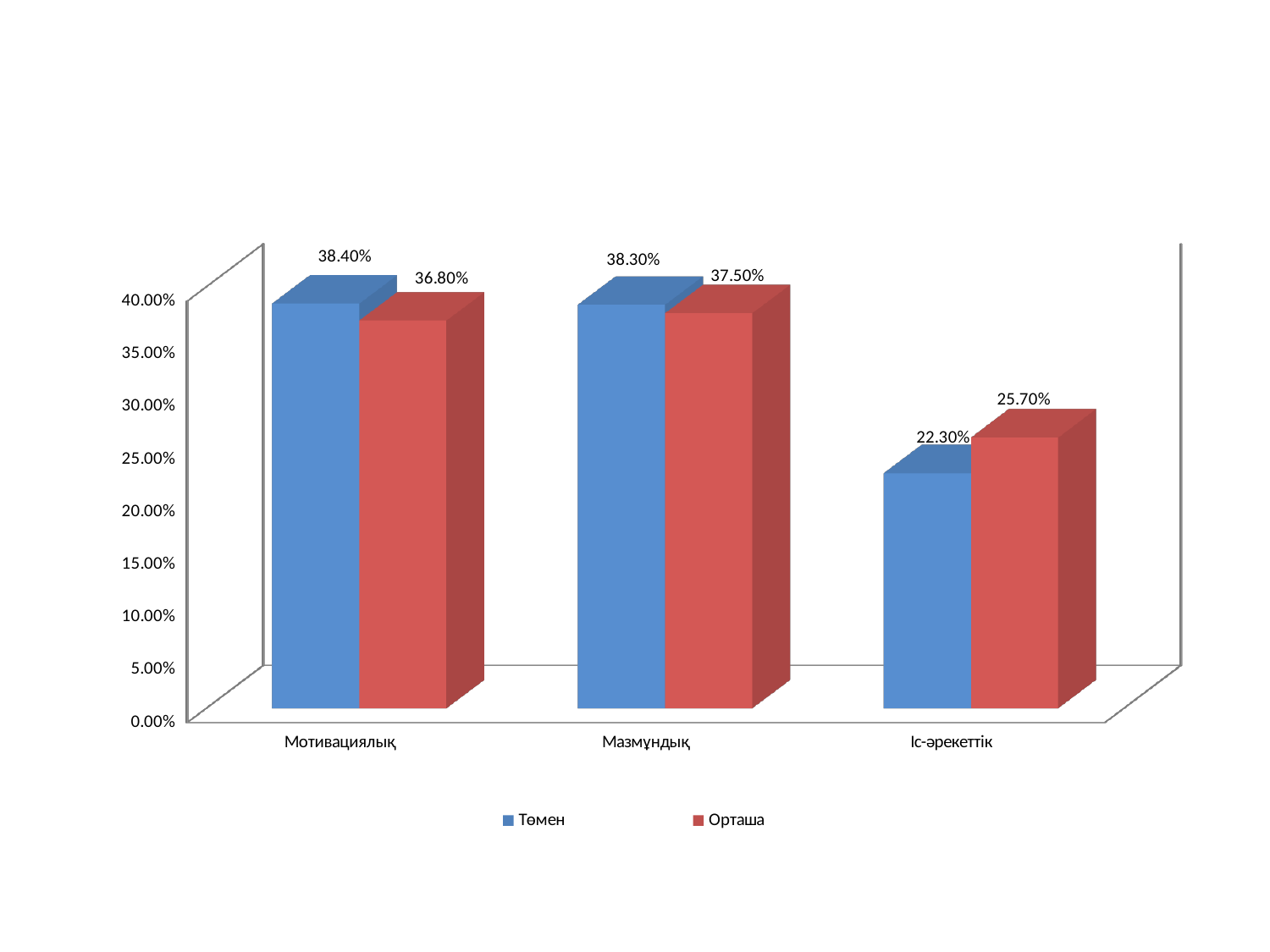
What is the value for Орташа in the Іс-әрекеттік category? 25.70% Which category has the lowest value for the Төмен series? Іс-әрекеттік What is the value for Орташа in the Мазмұндық category? 37.50% What is the difference between the Төмен and Орташа values in the Мотивациялық category? 1.60% What is the value for Төмен in the Мотивациялық category? 38.40% What is the difference between the Орташа and Төмен values in the Іс-әрекеттік category? 3.40% How many categories are shown on the x axis? 3 What kind of chart is shown on the slide? Bar chart What is the value for Төмен in the Іс-әрекеттік category? 22.30% In the Іс-әрекеттік category, which series has the larger value, Төмен or Орташа? Орташа Which category has the lowest value for the Орташа series? Іс-әрекеттік How many series does the legend list? 2